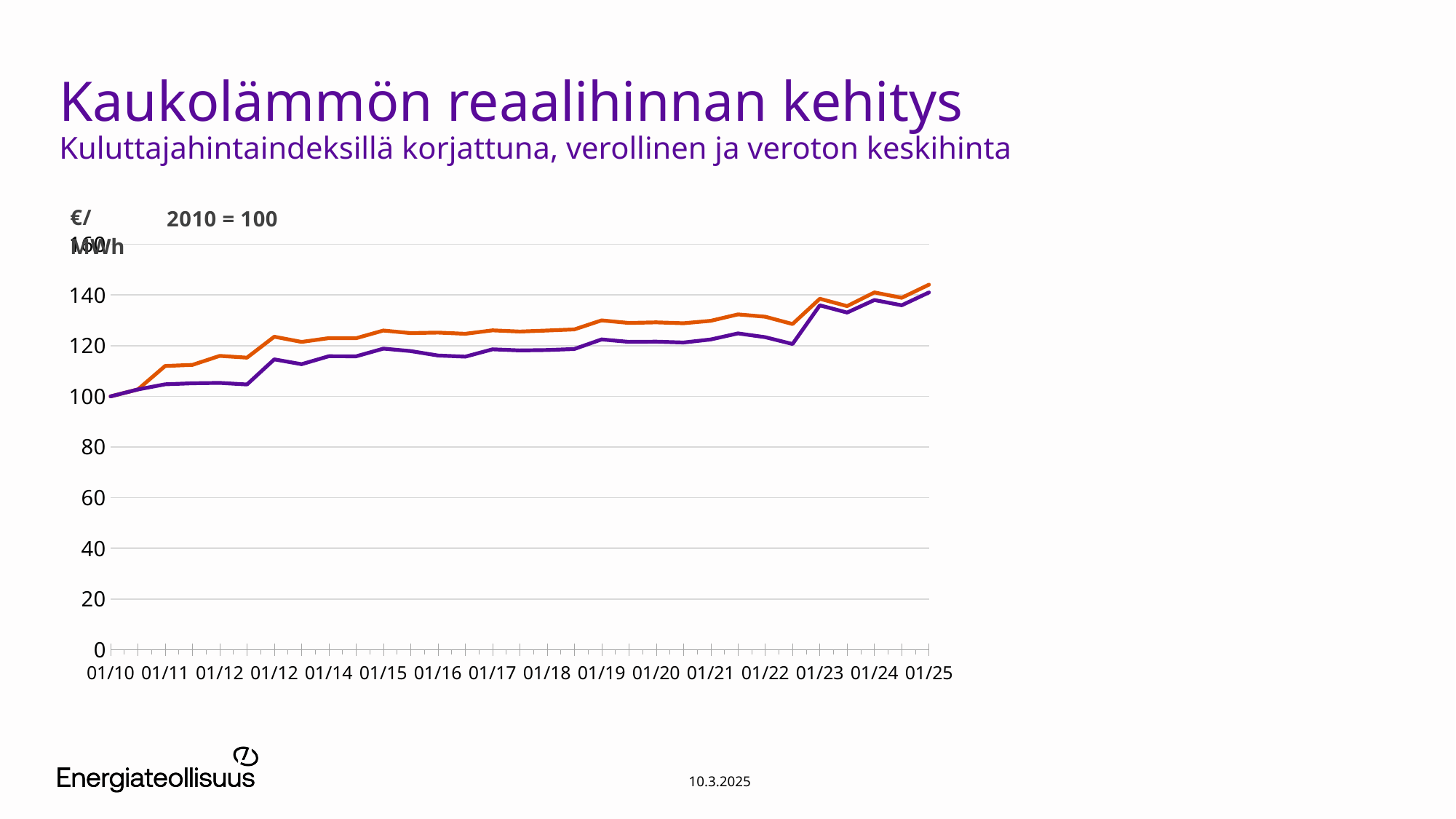
What kind of chart is shown on the slide? line chart Do the lines generally rise or fall from 01/10 to 01/25? rise What value do both lines have at 01/10? 100 Is the value of the purple line at 01/16 greater or less than 120? less How many lines are plotted in the chart? 2 Is the value of the orange line at 01/25 greater or less than 140? greater At which x-axis label does the orange line reach its lowest value? 01/10 At which x-axis label does the orange line reach its highest value? 01/25 Which line is higher at 01/20, the orange line or the purple line? orange What is the title of the chart on the slide? Kaukolämmön reaalihinnan kehitys Is the value of the orange line at 01/22 greater or less than 140? less What base-year annotation is printed above the chart? 2010 = 100